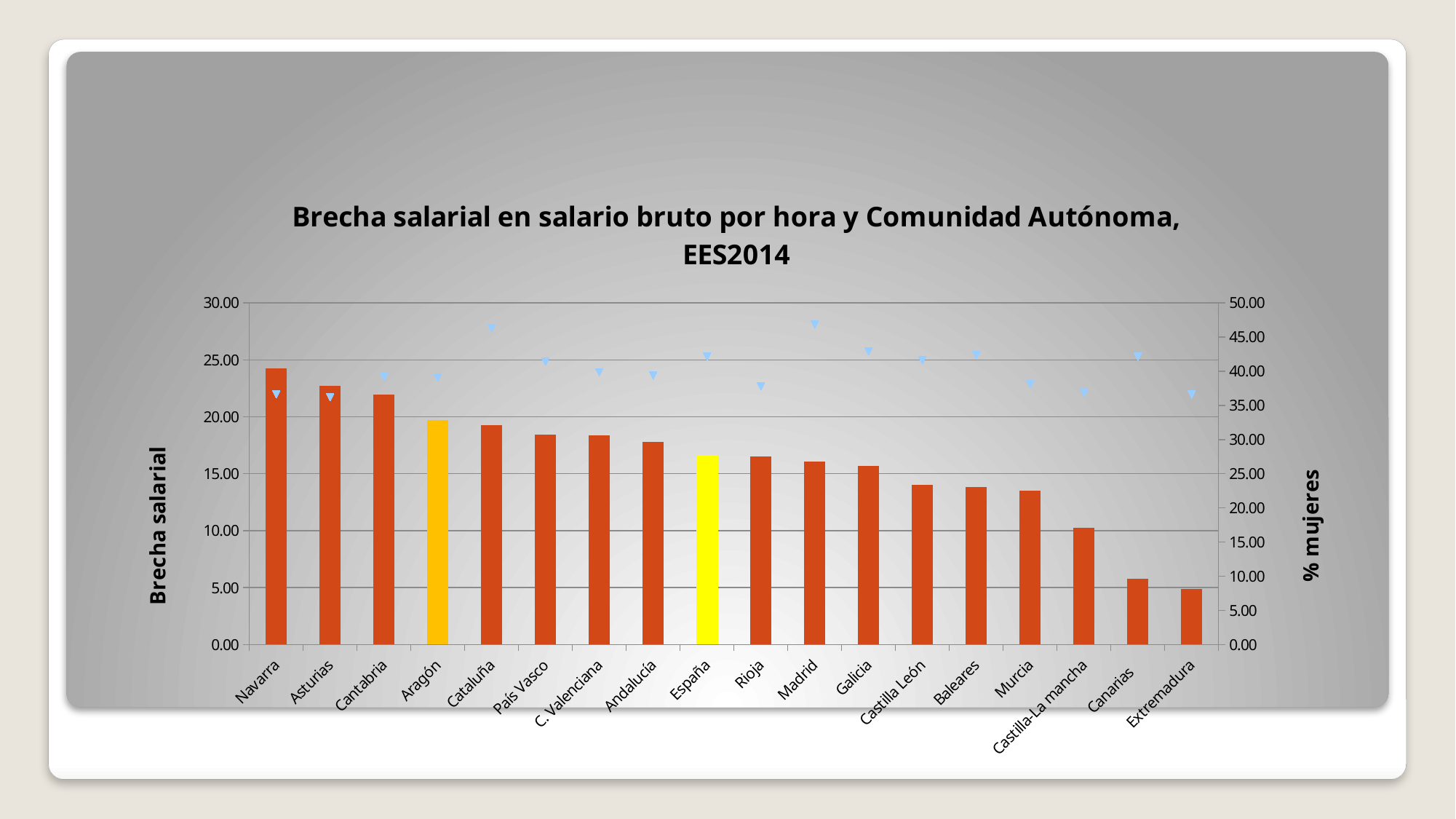
Which region has the lowest bar for Brecha salarial? Extremadura Is the Brecha salarial bar for Murcia greater or less than 15.00? less Is the Brecha salarial bar for España greater or less than 15.00? greater Which region has the highest bar for Brecha salarial? Navarra Do the Brecha salarial bars rise or fall from left to right along the x axis? Fall What kind of chart is shown on the slide? Bar chart How many regions (categories) are shown along the x axis? 18 Is the Brecha salarial bar for Canarias greater or less than 10.00? less Which has a larger Brecha salarial bar, Cantabria or Murcia? Cantabria What is the label of the right-hand (secondary) vertical axis? % mujeres What is the title of the chart? Brecha salarial en salario bruto por hora y Comunidad Autónoma, EES2014